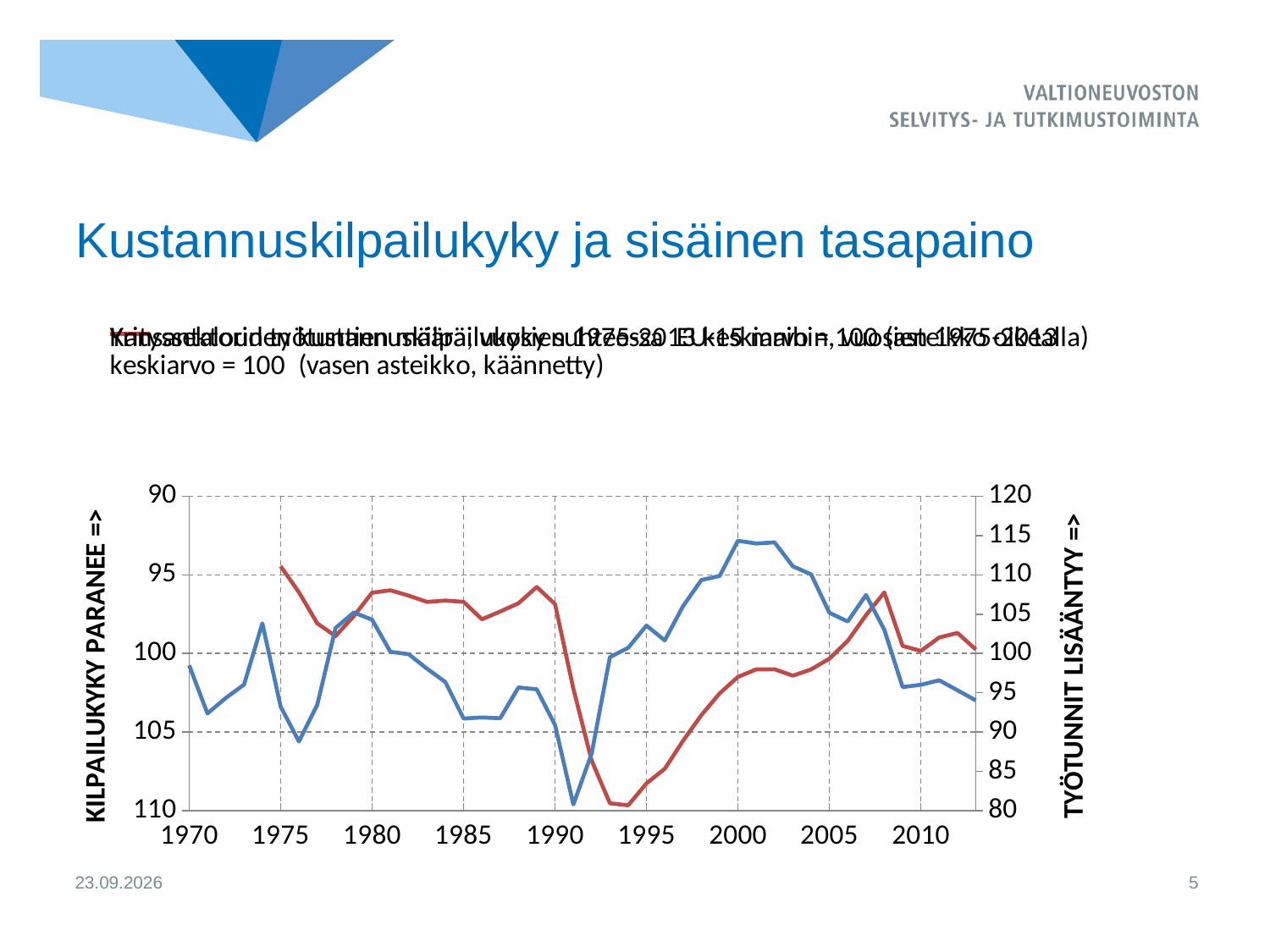
Is the blue line's value in 2000, read on the left axis, greater or less than 95? less Is the red line's value in 1975, read on the right axis, greater or less than 105? greater What is the label of the left-hand vertical axis? KILPAILUKYKY PARANEE => Is the red line's value in 2008, read on the right axis, greater or less than 105? greater What is the lowest value shown on the right-hand vertical axis? 80 Does the red line rise or fall between 1994 and 2008? rise How many lines are plotted on the chart? 2 What kind of chart is shown on the slide? line chart Does the red line rise or fall between 2008 and 2010? fall In which year does the blue line reach its lowest point on the chart? 1991